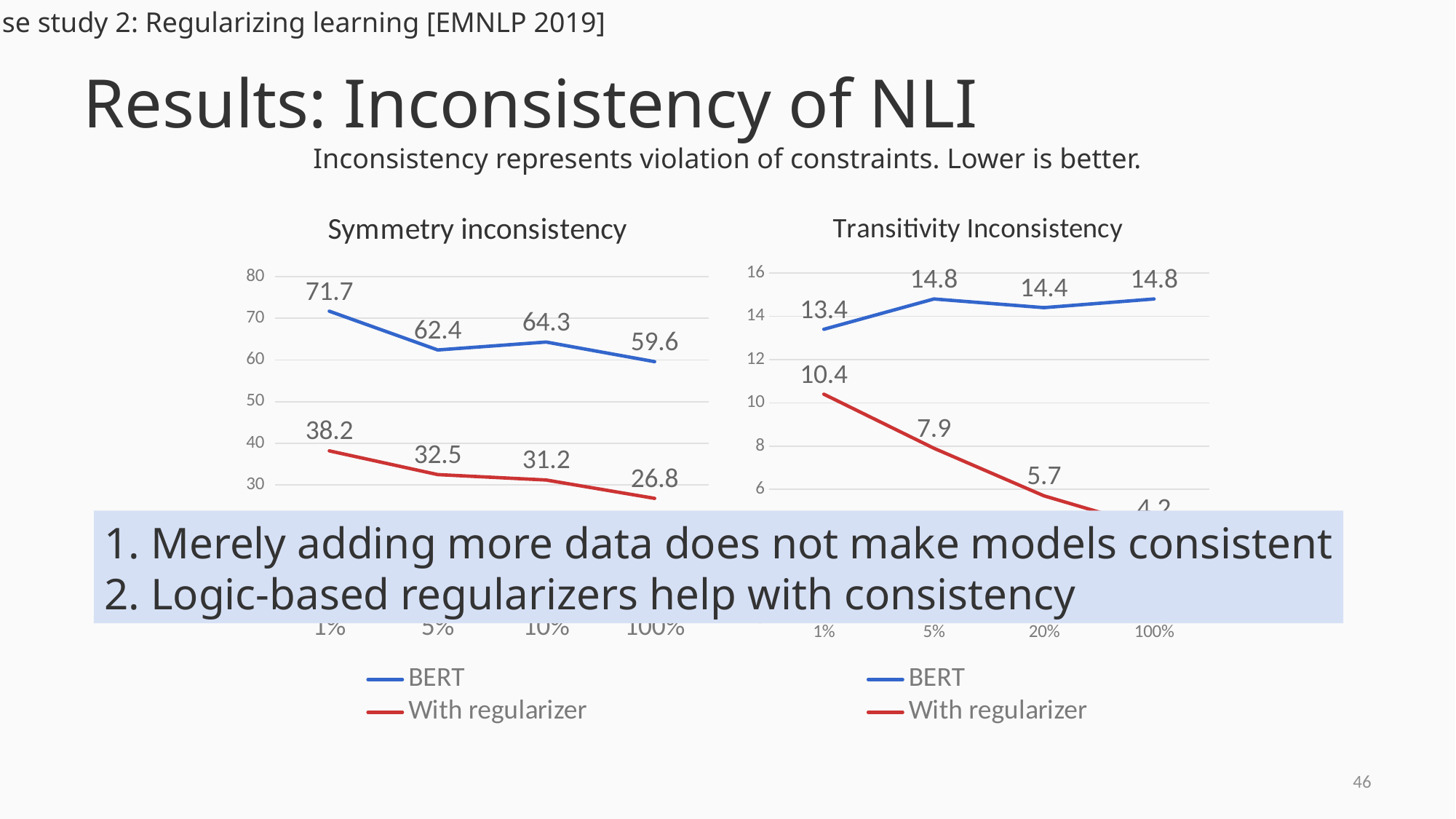
In the Symmetry inconsistency chart, what is the BERT value at 1%? 71.7 In the Transitivity Inconsistency chart, at which x-axis category is the With regularizer value highest? 1% In the Transitivity Inconsistency chart, what is the BERT value at 20%? 14.4 In the Transitivity Inconsistency chart, does the With regularizer line rise or fall from 1% to 100%? fall What kind of chart is the Transitivity Inconsistency chart? line chart In the Symmetry inconsistency chart, what is the difference between the BERT and With regularizer values at 1%? 33.5 In the Symmetry inconsistency chart, at which x-axis category is the BERT value lowest? 100% How many series does the legend of the Symmetry inconsistency chart list? 2 In the Symmetry inconsistency chart, what is the With regularizer value at 100%? 26.8 In the Transitivity Inconsistency chart, what is the difference between the With regularizer values at 1% and 100%? 6.2 In the Transitivity Inconsistency chart, what is the With regularizer value at 5%? 7.9 In the Symmetry inconsistency chart, which is larger: the BERT value at 5% or the BERT value at 10%? BERT at 10%